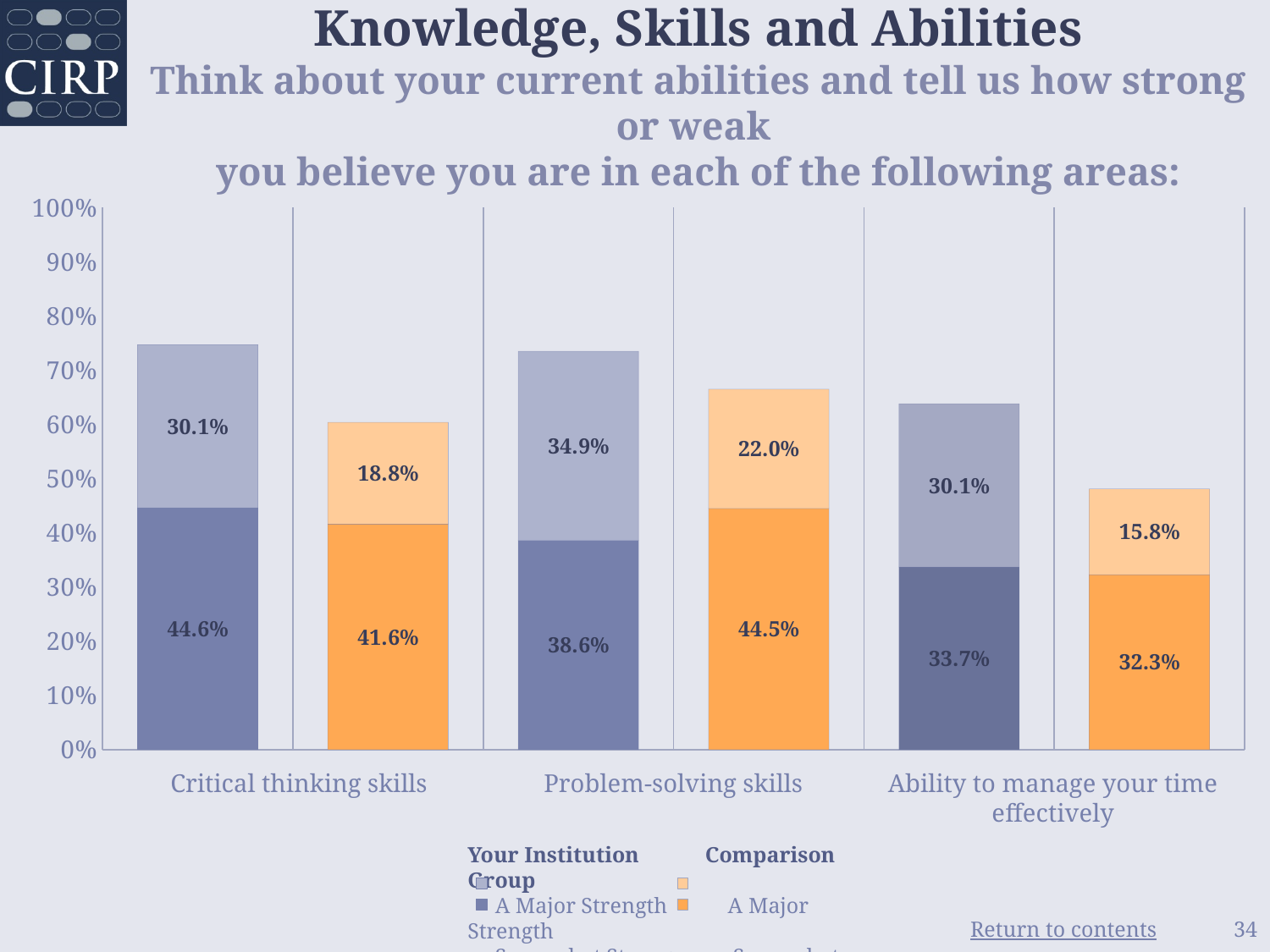
What is the total height of the Your Institution stacked bar for critical thinking skills? 74.7% What is the value of the upper (lighter) segment of the Comparison Group bar for ability to manage your time effectively? 15.8% Which is larger for problem-solving skills: the Your Institution 'A Major Strength' value or the Comparison Group 'A Major Strength' value? Comparison Group For which area is the Comparison Group 'A Major Strength' value highest? Problem-solving skills For which area is the Your Institution 'A Major Strength' value lowest? Ability to manage your time effectively How many skill areas are shown on the x axis of the chart? 3 What is the difference between the Your Institution and Comparison Group 'A Major Strength' values for critical thinking skills? 3.0% What type of chart is shown on the slide? Stacked bar chart What percentage of the Comparison Group rated problem-solving skills as a major strength? 44.5% What percentage of Your Institution students rated critical thinking skills as a major strength? 44.6% What is the total height of the Comparison Group stacked bar for ability to manage your time effectively? 48.1% What is the value of the upper (lighter) segment of the Your Institution bar for problem-solving skills? 34.9%